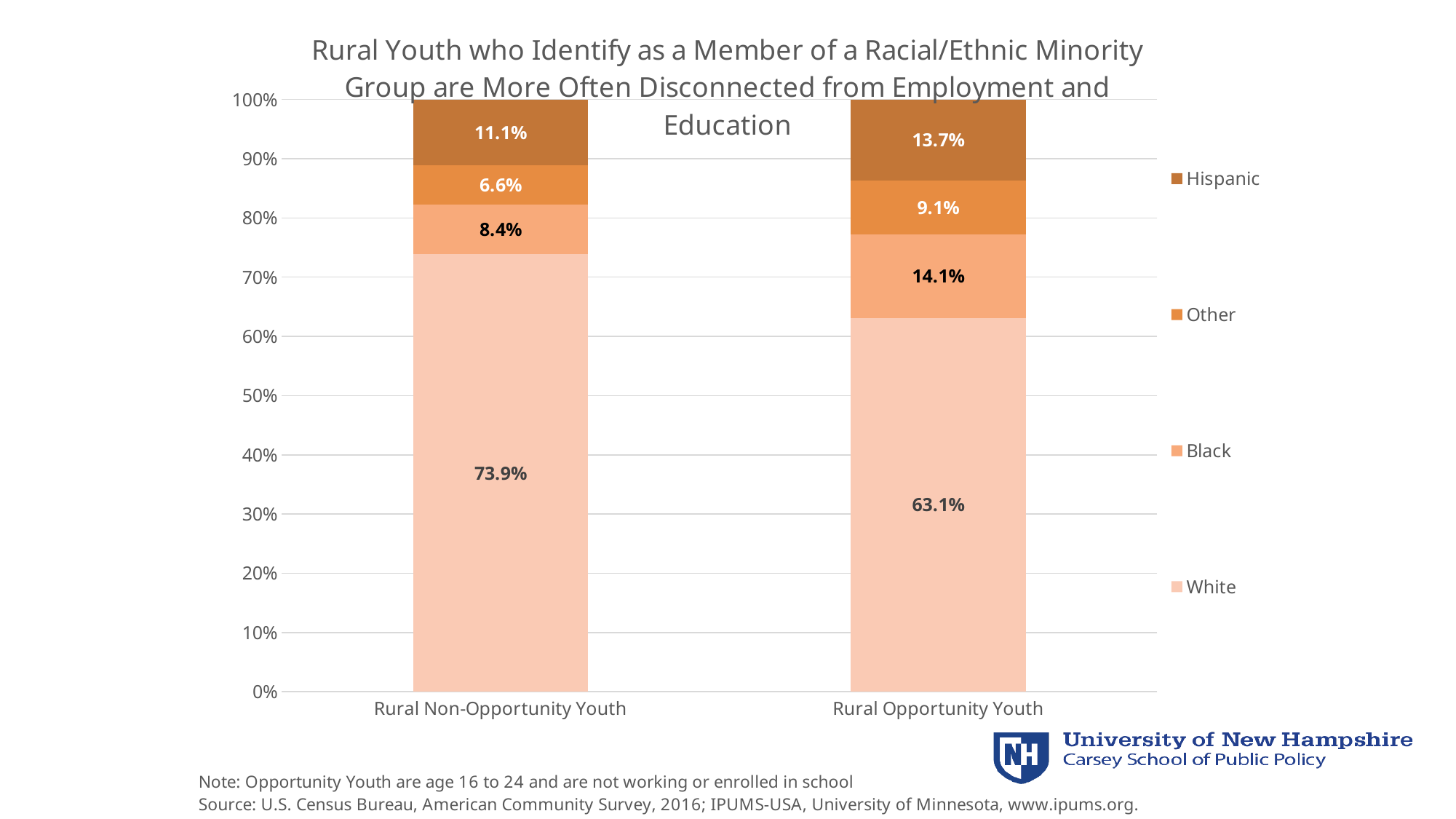
What is the Black share for Rural Opportunity Youth? 14.1% What percentage of Rural Non-Opportunity Youth are White? 73.9% How many series does the legend list? 4 Which category has the larger Hispanic share? Rural Opportunity Youth What is the difference in the White share between Rural Non-Opportunity Youth and Rural Opportunity Youth? 10.8% Which series is the smallest segment in the Rural Non-Opportunity Youth bar? Other How many categories are shown on the x axis? 2 What percentage of Rural Opportunity Youth are Hispanic? 13.7% What is the difference in the Black share between Rural Opportunity Youth and Rural Non-Opportunity Youth? 5.7% What is the Other share for Rural Non-Opportunity Youth? 6.6% What kind of chart is shown on the slide? Stacked bar chart Which category has the larger White share, Rural Non-Opportunity Youth or Rural Opportunity Youth? Rural Non-Opportunity Youth